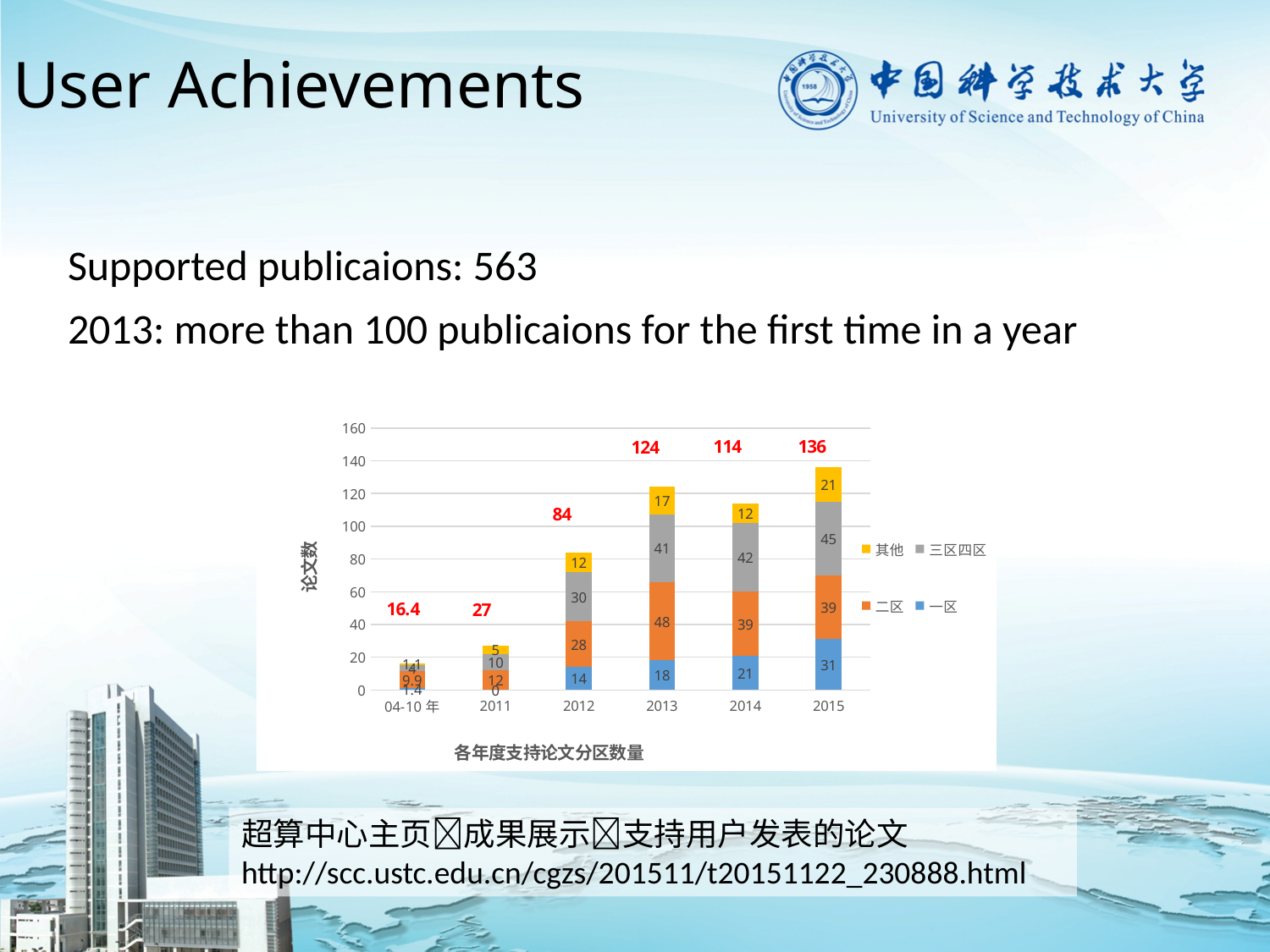
What is the difference between the total for 2013 and the total for 2014? 10 Which category has the lowest total number of publications? 04-10 年 What type of chart is shown on the slide? stacked bar chart Is the 二区 value for 2013 larger or smaller than the 二区 value for 2014? larger What is the title of the chart? 各年度支持论文分区数量 What is the total number of publications shown above the 2015 bar? 136 What is the 一区 value for 2015? 31 What is the 二区 value for 2013? 48 How many series does the legend list? 4 Which year has the highest total number of publications? 2015 What is the 三区四区 value for 2014? 42 What is the 其他 value for 2012? 12